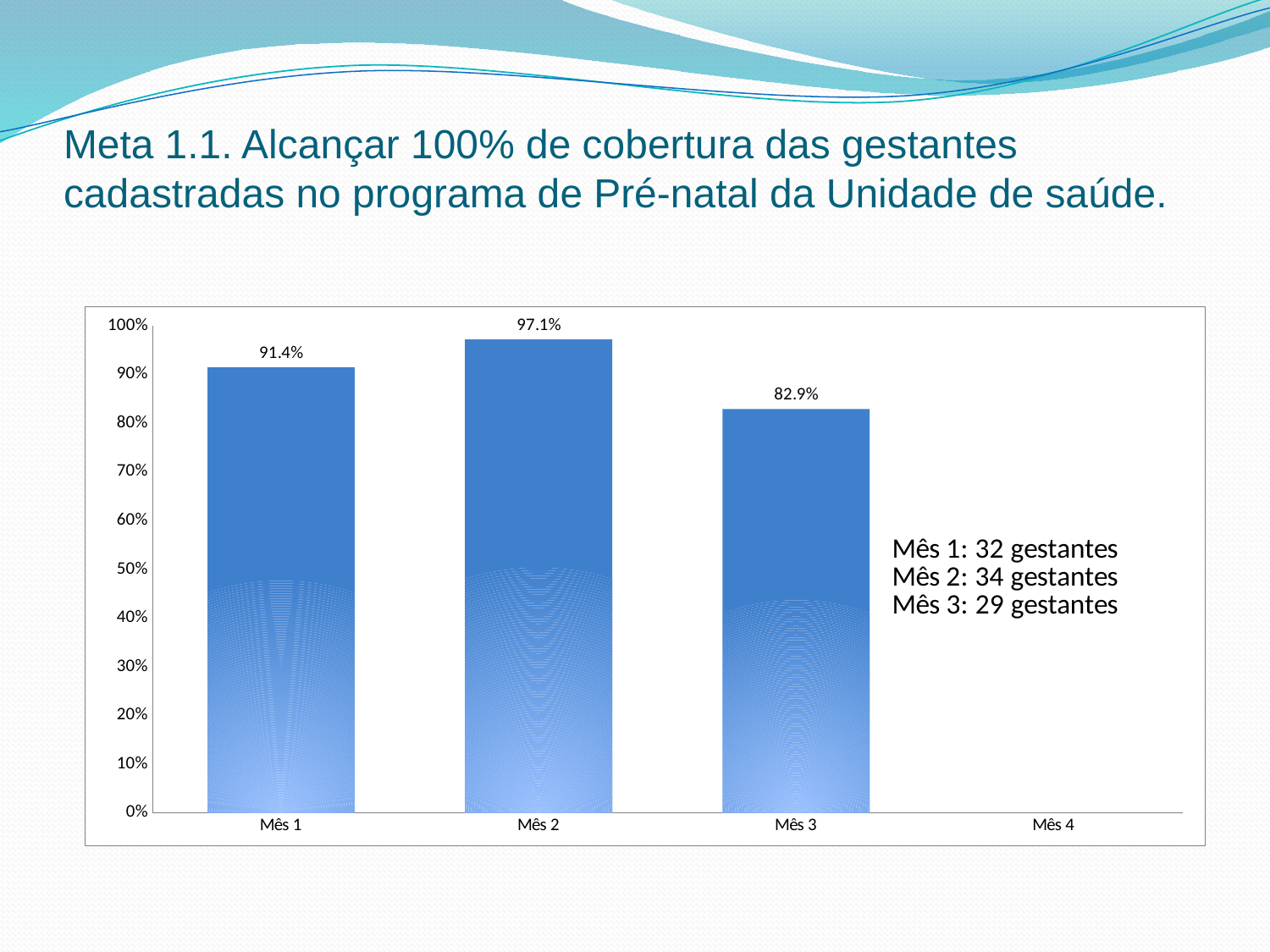
Is the value for Mês 3 greater or less than 90%? less What is the value for Mês 1? 91.4% Which month has the highest value? Mês 2 According to the text on the chart, how many gestantes were there in Mês 2? 34 gestantes What is the value for Mês 3? 82.9% What is the difference between the values for Mês 2 and Mês 1? 5.7% Among the months with a plotted bar, which has the lowest value? Mês 3 What is the value for Mês 2? 97.1% What kind of chart is shown on the slide? bar chart What is the difference between the values for Mês 2 and Mês 3? 14.2% How many categories are shown on the x axis? 4 Which is larger, the value for Mês 1 or the value for Mês 3? Mês 1